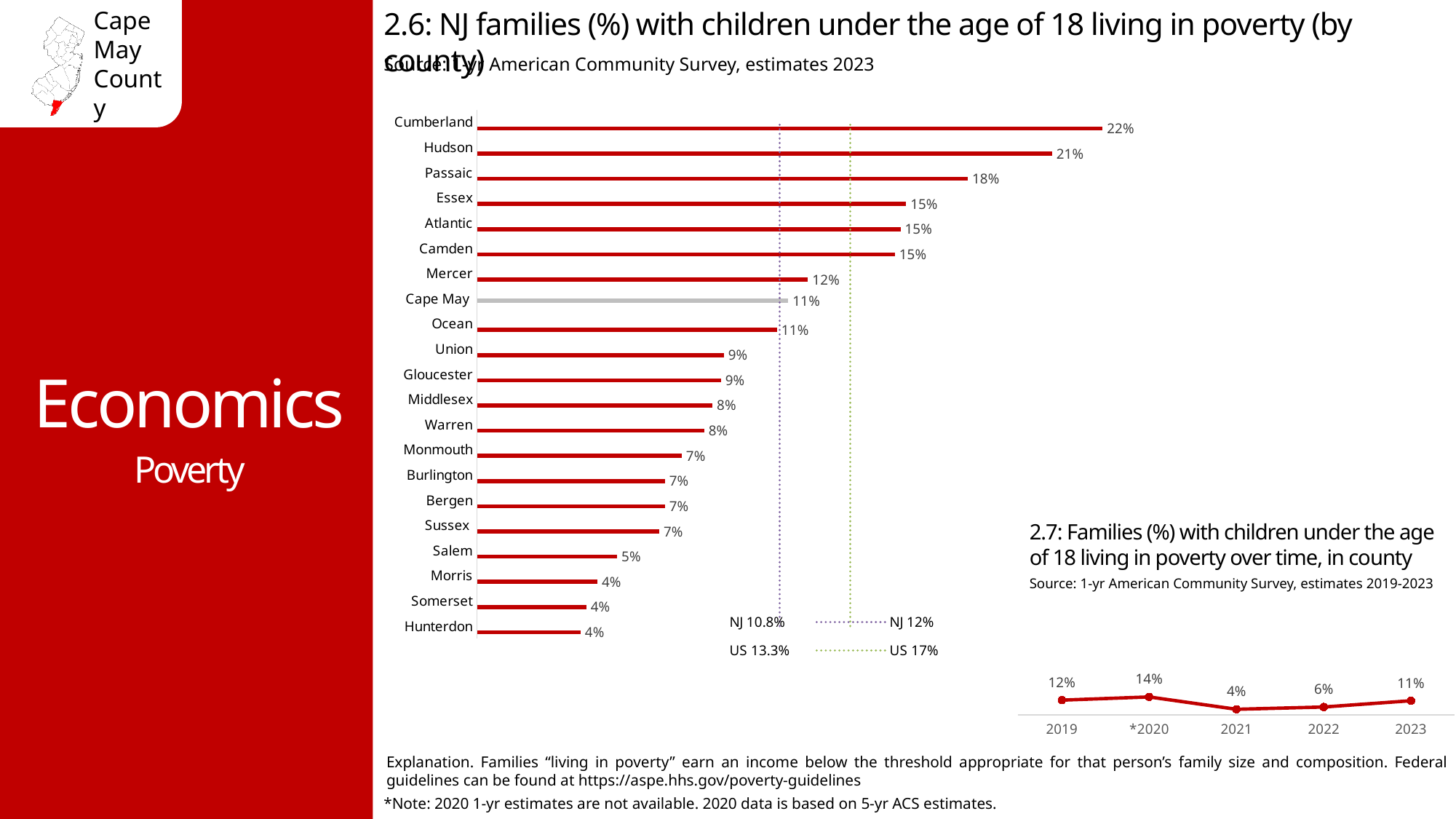
In chart 2.6 (by county), how many counties are plotted? 21 In chart 2.7 (over time, in county), which year has the highest value? *2020 In chart 2.6 (NJ families with children under 18 living in poverty by county), what is the value for Cape May? 11% In chart 2.6 (by county), what is the difference between Cumberland and Hunterdon? 18% In chart 2.6 (by county), what is the value for Salem? 5% In chart 2.6 (by county), which is larger, the value for Passaic or the value for Mercer? Passaic In chart 2.7 (families in poverty over time, in county), what is the value for 2021? 4% In chart 2.6 (by county), which county has the highest value? Cumberland In chart 2.6 (by county), what is the value for Cumberland? 22% What kind of chart is chart 2.6 (by county)? Bar chart In chart 2.7 (over time, in county), what is the difference between 2023 and 2022? 5%